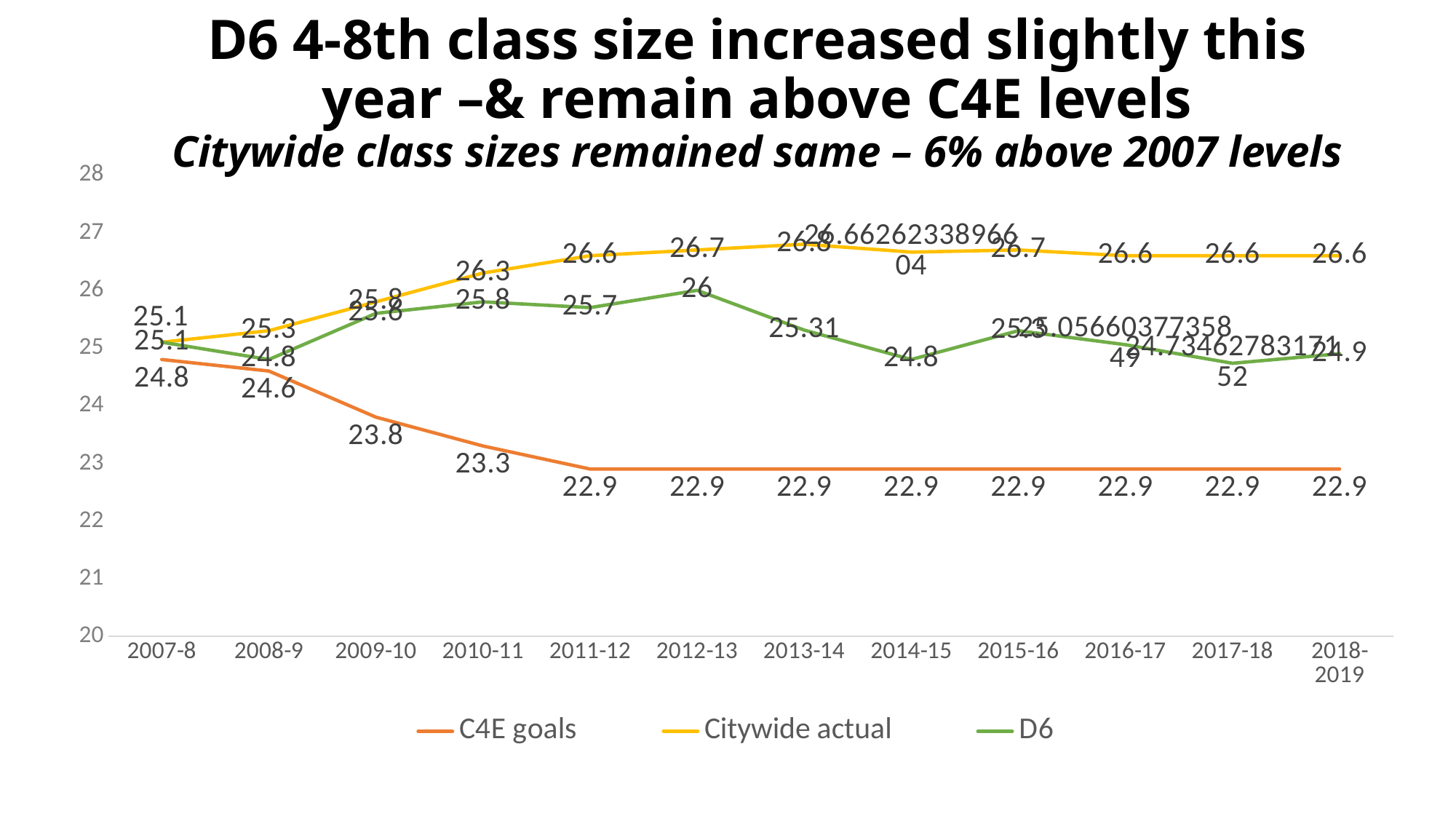
In 2012-13, which is larger: Citywide actual or D6? Citywide actual How many series does the legend list? 3 What type of chart is shown on the slide? line chart What is the C4E goals value for 2007-8? 24.8 What is the C4E goals value for 2009-10? 23.8 Do the C4E goals values rise or fall from 2007-8 to 2011-12? fall What is the D6 value for 2018-2019? 24.9 In which year is the D6 series at its highest? 2012-13 What is the D6 value for 2014-15? 24.8 What is the Citywide actual value for 2010-11? 26.3 How many school years are shown on the x axis? 12 What is the difference between the Citywide actual and D6 values in 2018-2019? 1.7